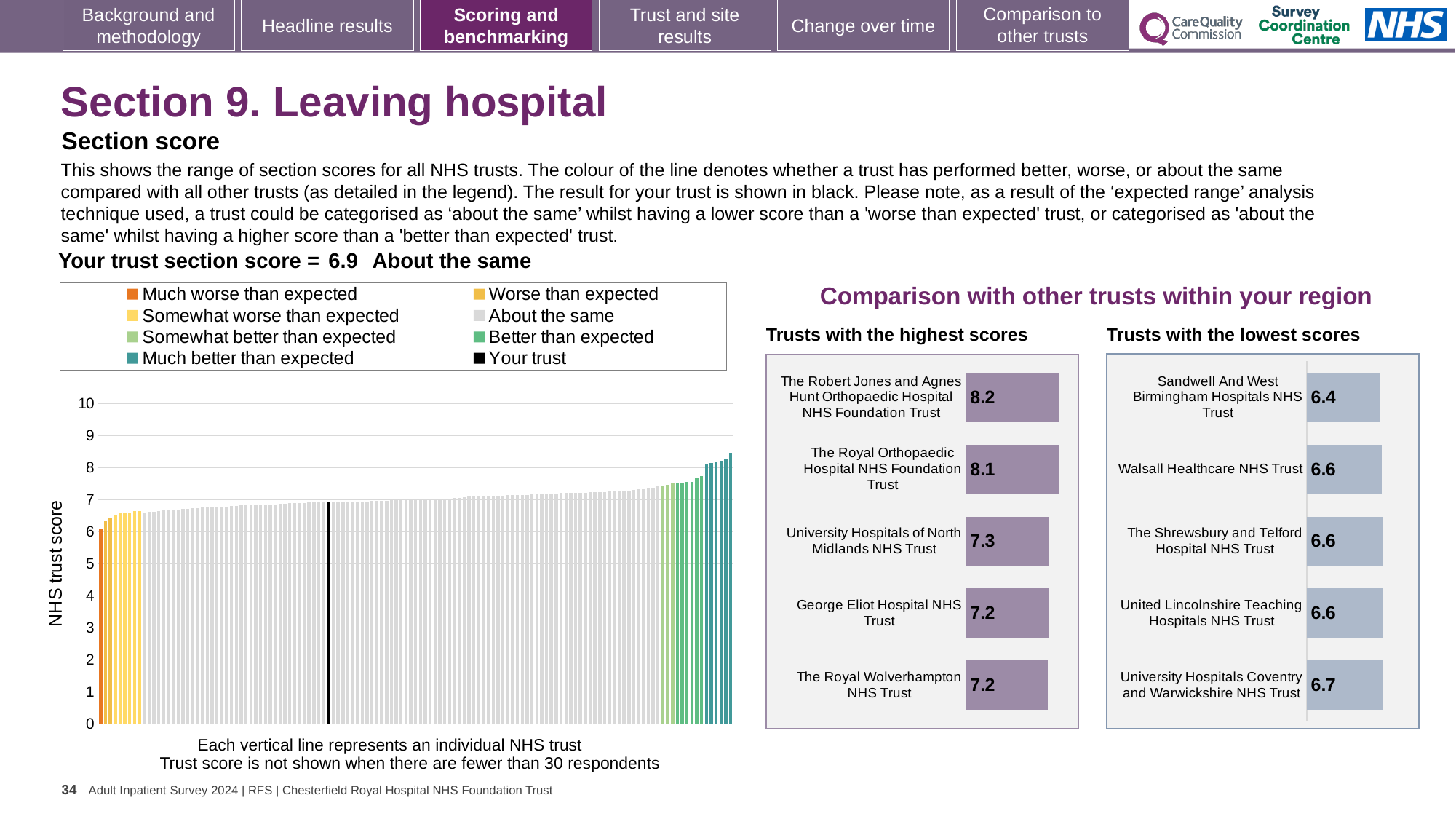
In the 'Trusts with the highest scores' chart, what is the score for University Hospitals of North Midlands NHS Trust? 7.3 In the 'Trusts with the lowest scores' chart, which trust has the lowest score? Sandwell And West Birmingham Hospitals NHS Trust How many entries does the legend above the main NHS trust score chart list? 8 In the 'Trusts with the highest scores' chart, which has the higher score: The Royal Orthopaedic Hospital NHS Foundation Trust or George Eliot Hospital NHS Trust? The Royal Orthopaedic Hospital NHS Foundation Trust In the main NHS trust score chart on the left, is the value for your trust greater or less than 5? greater How many trusts are listed in the 'Trusts with the lowest scores' chart? 5 In the 'Trusts with the highest scores' chart, what is the score for The Robert Jones and Agnes Hunt Orthopaedic Hospital NHS Foundation Trust? 8.2 In the 'Trusts with the highest scores' chart, what is the difference between the scores of The Robert Jones and Agnes Hunt Orthopaedic Hospital NHS Foundation Trust and The Royal Wolverhampton NHS Trust? 1.0 What kind of chart is the main NHS trust score chart on the left? Bar chart In the main NHS trust score chart on the left, do the trust scores rise or fall from left to right? Rise In the 'Trusts with the lowest scores' chart, what is the score for University Hospitals Coventry and Warwickshire NHS Trust? 6.7 In the main NHS trust score chart on the left, what is the section score for your trust? 6.9